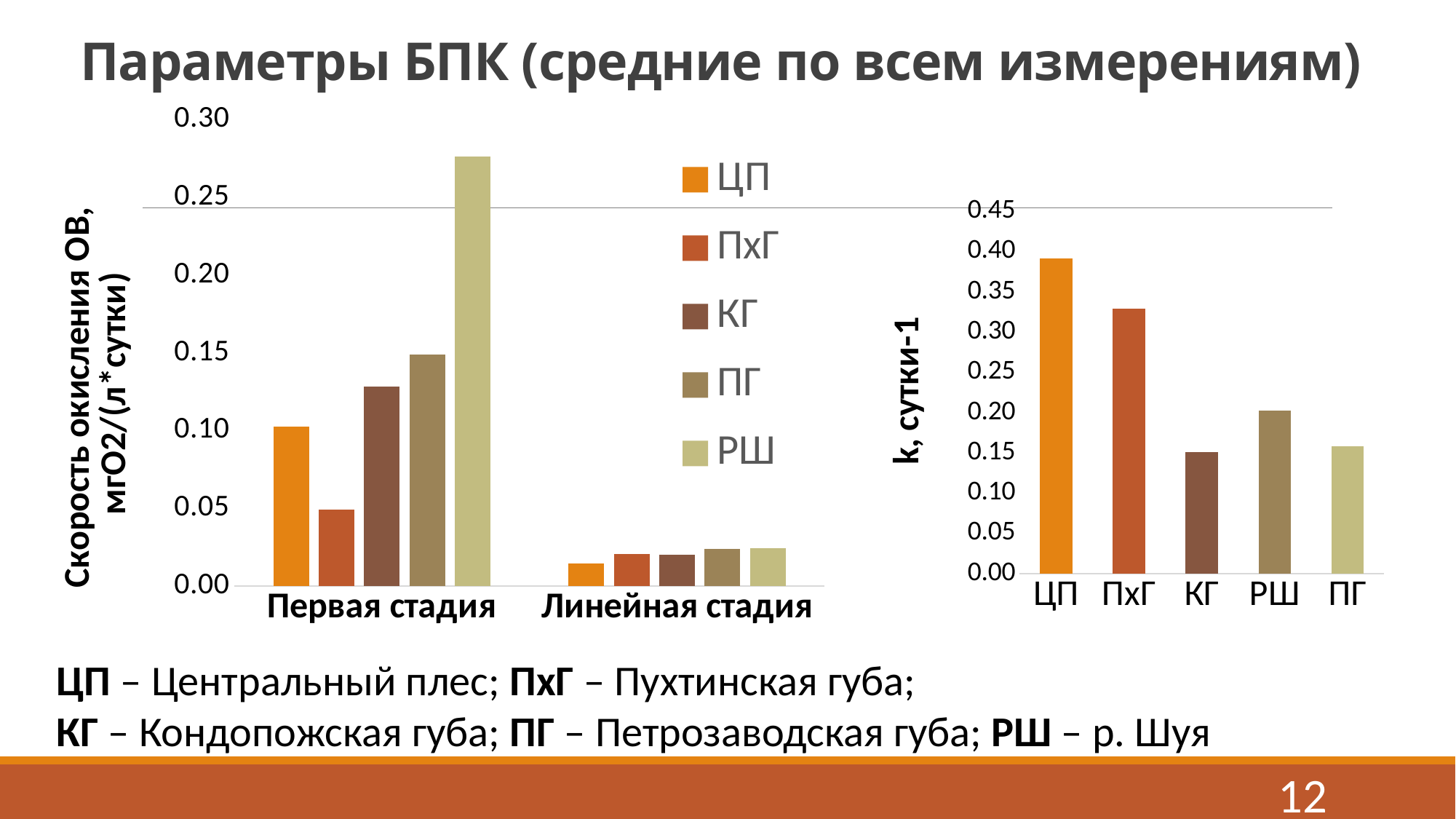
What kind of chart is the left chart on the slide? bar chart In the left chart, is the value for ПхГ in Первая стадия greater or less than 0.10? less How many series does the legend of the left chart list? 5 What is the y-axis label of the right chart? k, сутки-1 In the left chart, is the value for РШ in Первая стадия greater or less than 0.25? greater How many categories are shown on the x axis of the left chart? 2 In the right chart (k, сутки-1), which category has the highest value? ЦП In the right chart (k, сутки-1), is the value for ЦП greater or less than 0.35? greater In the left chart, which series has the lowest bar in the Первая стадия category? ПхГ In the left chart, which series has the highest bar in the Первая стадия category? РШ In the left chart, which is larger in Первая стадия: the bar for РШ or the bar for ЦП? РШ How many categories are shown on the x axis of the right chart (k, сутки-1)? 5